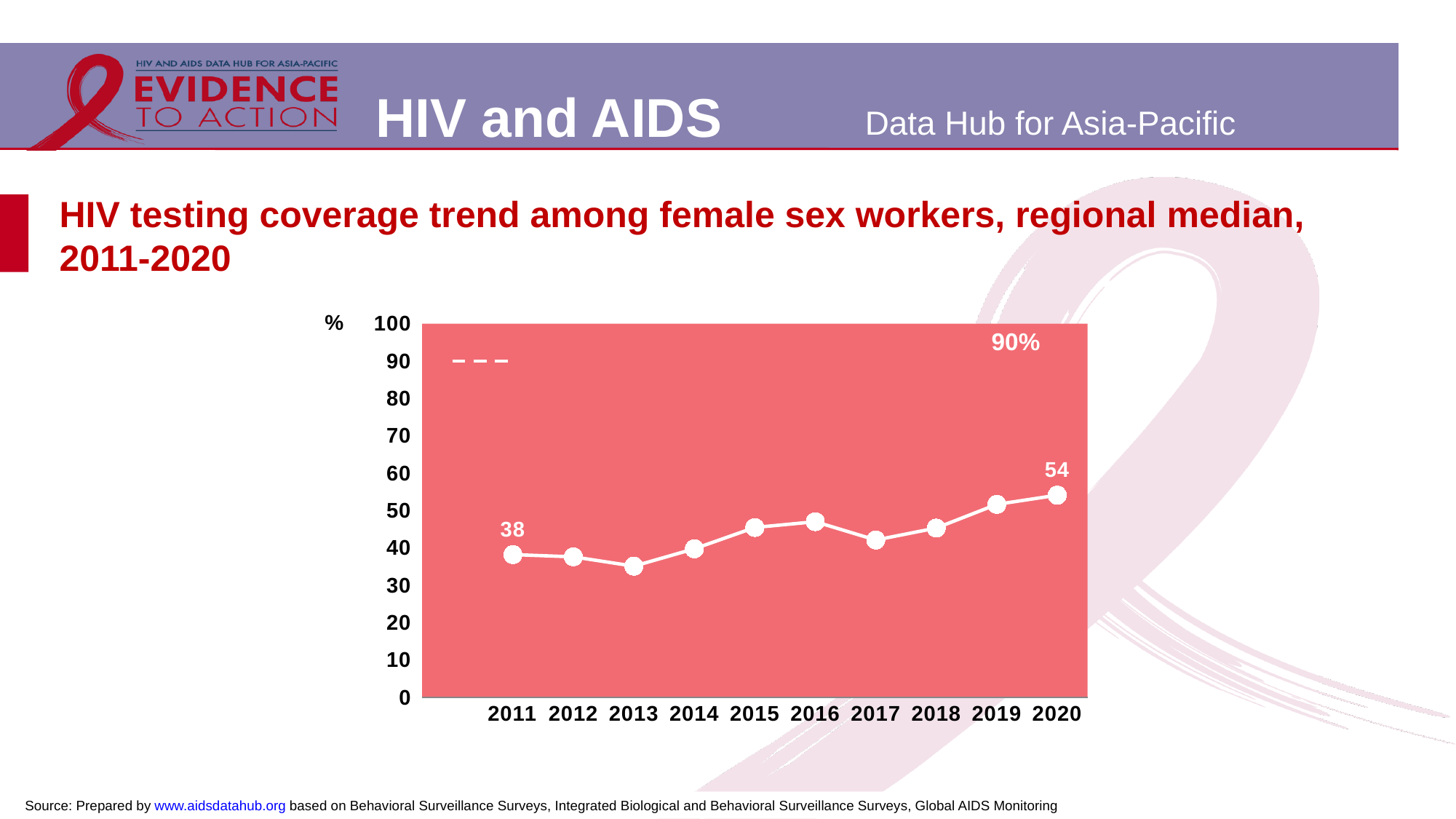
Do the values generally rise or fall from 2011 to 2020? rise What is the HIV testing coverage value for 2011? 38 By how much did the regional median HIV testing coverage increase from 2011 to 2020? 16 What kind of chart is shown on the slide? line chart Which year has the higher value, 2011 or 2020? 2020 Is the value for 2016 greater or less than 40? greater What is the HIV testing coverage value for 2020? 54 Is the value for 2013 greater or less than 40? less Is the value for 2017 greater or less than 50? less Which year has the lowest HIV testing coverage value? 2013 How many years are plotted on the x axis? 10 What target value does the dashed line at the top of the chart represent? 90%